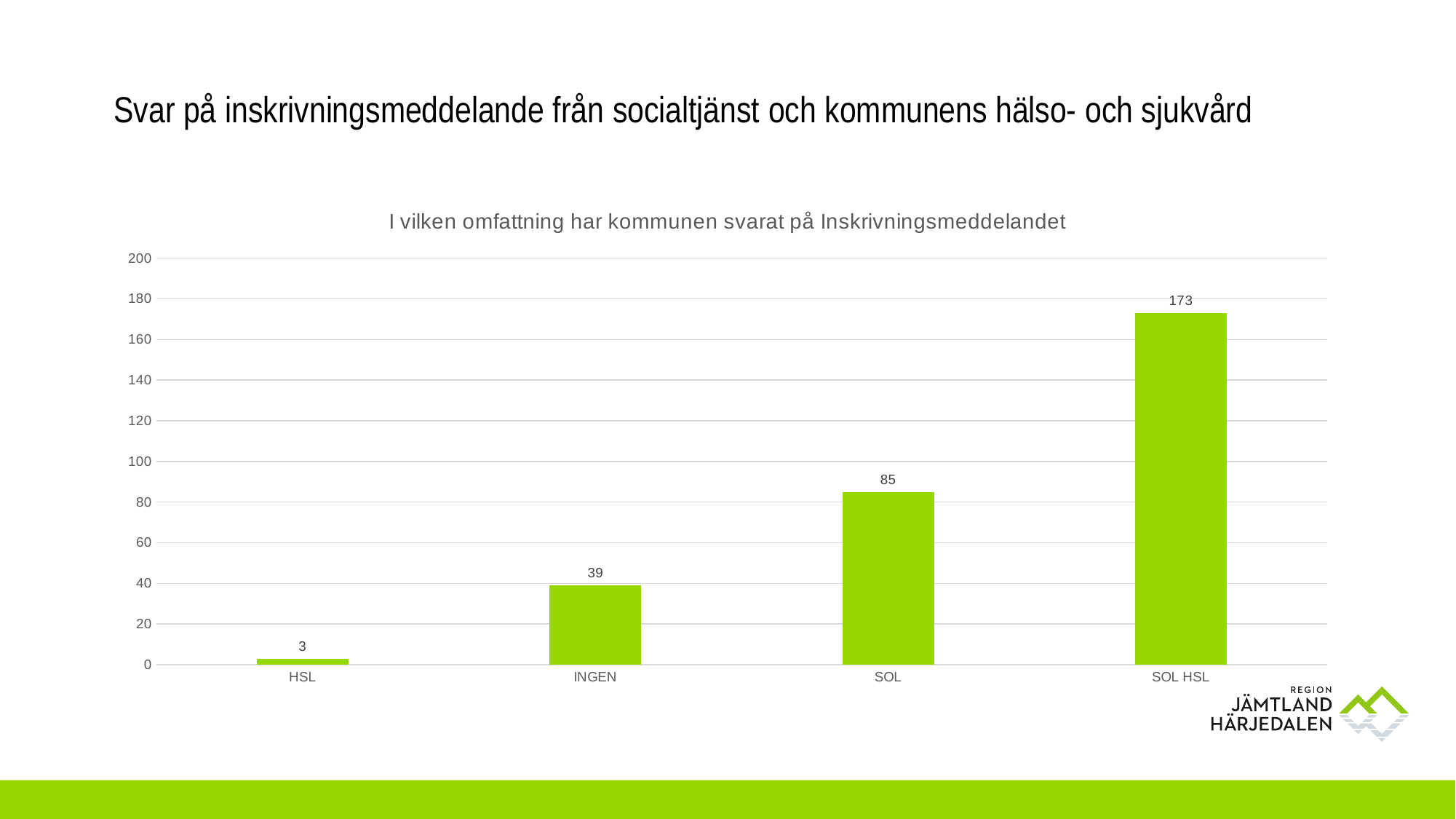
What is the title of the chart? I vilken omfattning har kommunen svarat på Inskrivningsmeddelandet Which is larger, the value for SOL or the value for INGEN? SOL What is the value for SOL HSL? 173 What is the value for INGEN? 39 Which category has the highest value? SOL HSL Is the value for SOL greater or less than 100? less Do the values rise or fall from left to right along the x axis? rise How many categories are shown on the x axis? 4 What is the value for HSL? 3 What kind of chart is shown? bar chart Which category has the lowest value? HSL What is the difference between the values for SOL HSL and SOL? 88